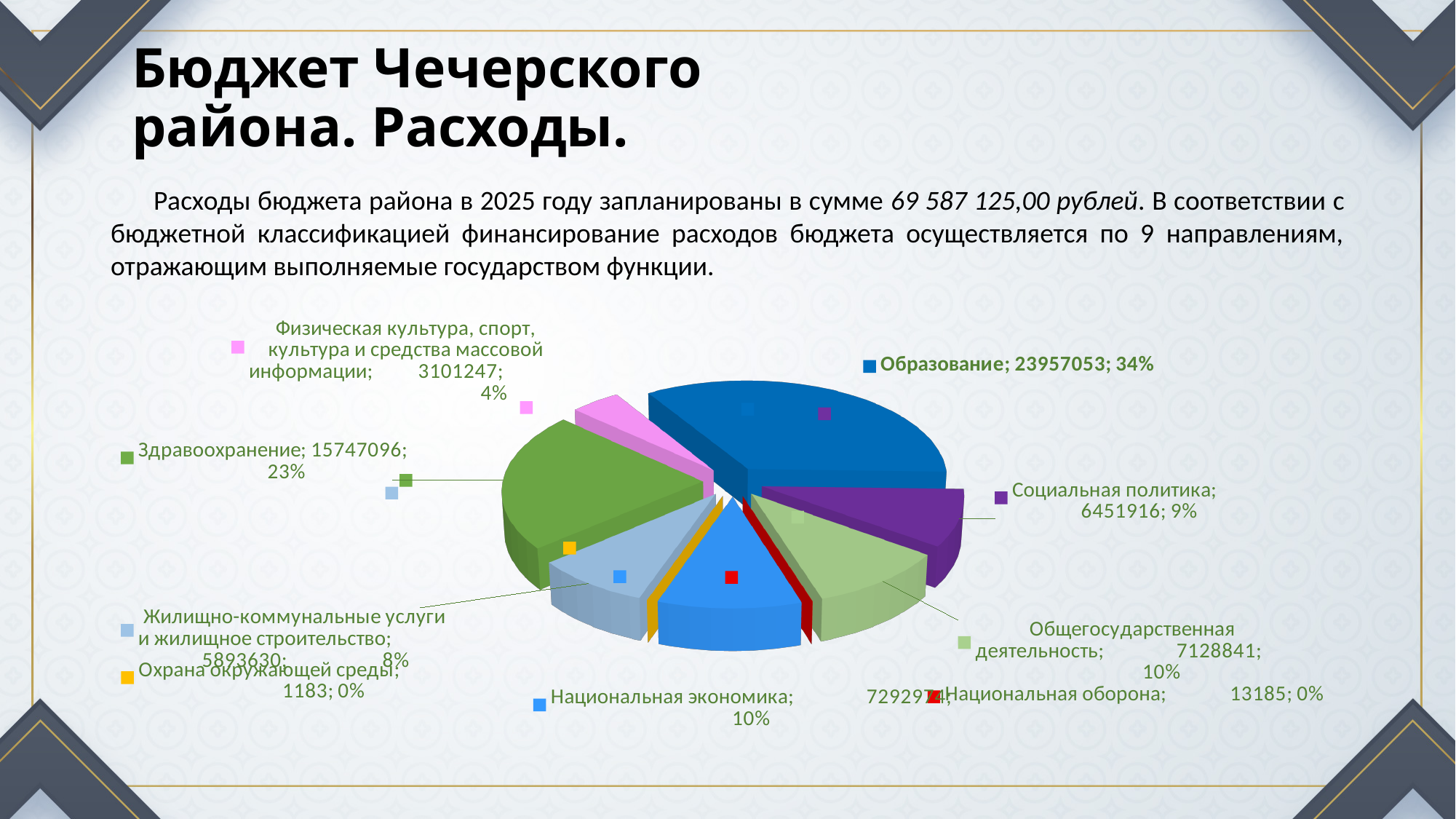
Which category has the largest slice of the pie? Образование What kind of chart is shown on the slide? pie chart What is the value shown for Социальная политика? 6451916 How many categories (slices) does the pie chart have? 9 Which is larger: Социальная политика or Общегосударственная деятельность? Общегосударственная деятельность What share of the pie does Здравоохранение represent? 23% Which category has the smallest value in the pie chart? Охрана окружающей среды What share of the pie does Образование represent? 34% What is the difference between the values for Образование and Здравоохранение? 8209957 What is the value shown for Здравоохранение? 15747096 What is the value shown for Образование? 23957053 What share of the pie does Физическая культура, спорт, культура и средства массовой информации represent? 4%